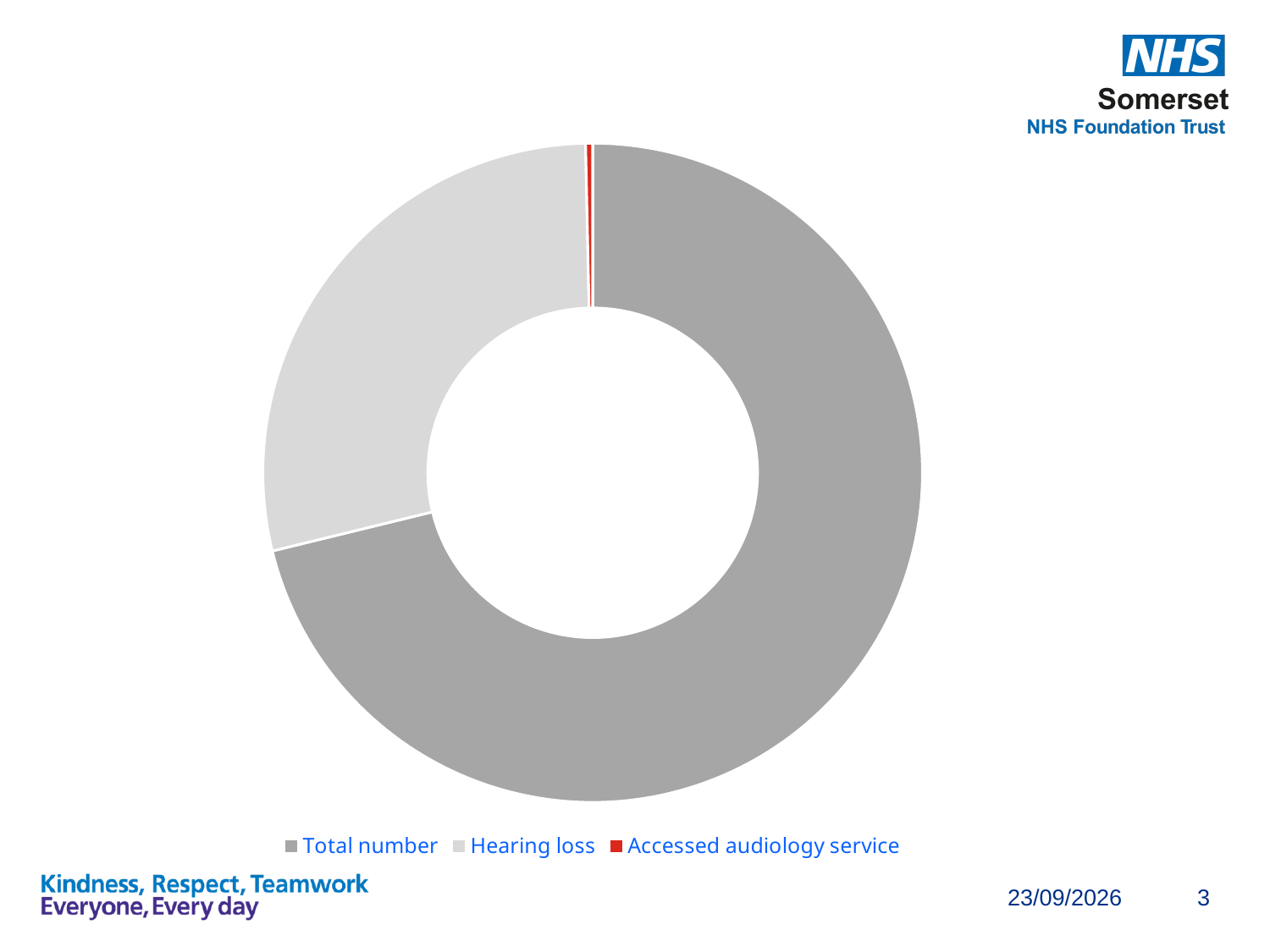
Which slice is larger, Total number or Hearing loss? Total number Which category has the largest slice of the doughnut chart? Total number How many entries does the legend list? 3 What is the first entry listed in the chart legend? Total number Which category is shown in red on the doughnut chart? Accessed audiology service Which slice is larger, Hearing loss or Accessed audiology service? Hearing loss How many categories does the doughnut chart show? 3 What kind of chart is shown on the slide? doughnut chart Which category has the smallest slice of the doughnut chart? Accessed audiology service